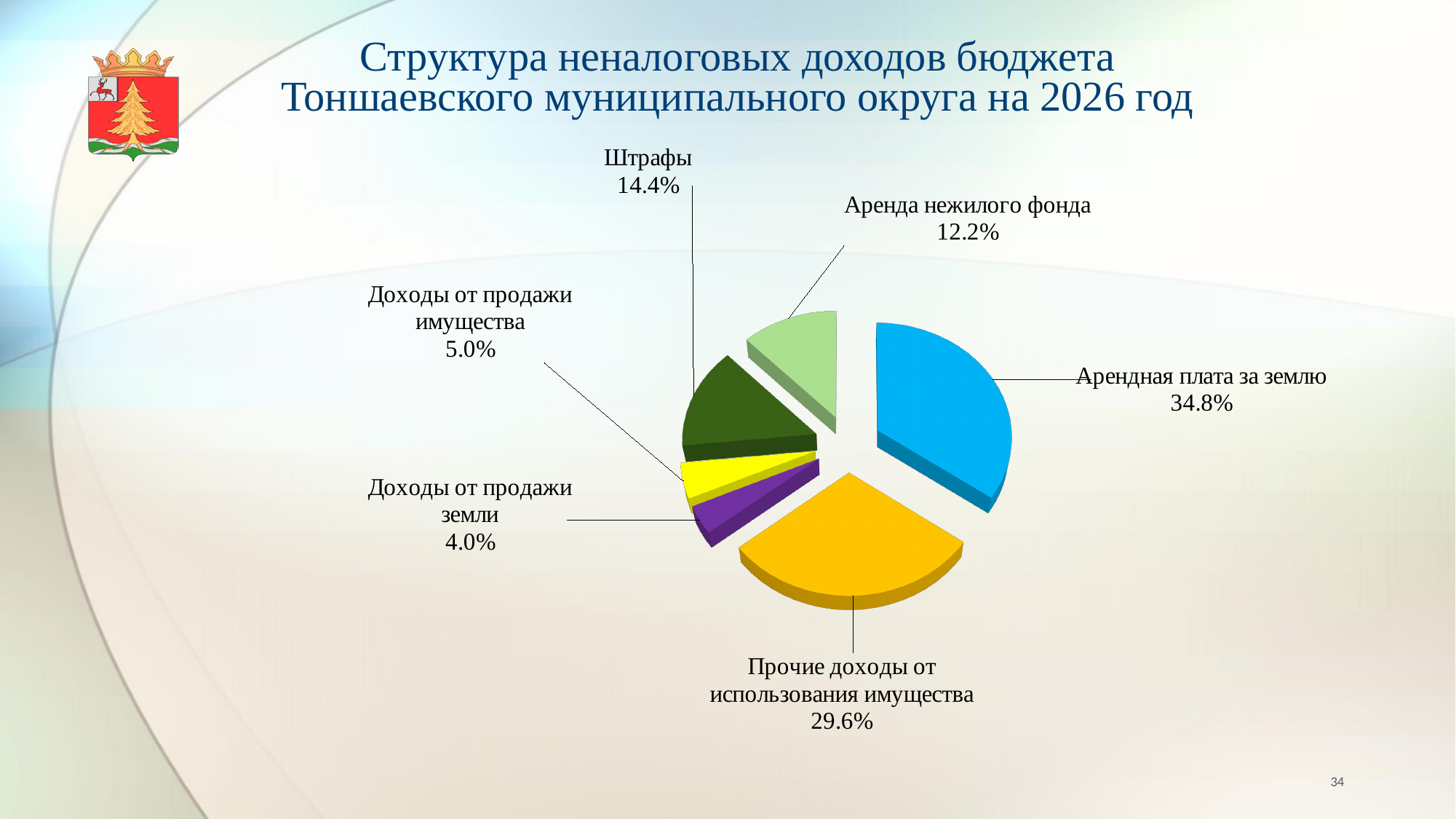
What percentage is labelled for "Штрафы"? 14.4% How many categories are shown in the pie chart? 6 What colour is the slice for "Арендная плата за землю"? Blue What share is shown for "Прочие доходы от использования имущества"? 29.6% What type of chart is shown on the slide? Pie chart Which category has the largest share of the pie? Арендная плата за землю What is the difference in percentage points between "Арендная плата за землю" and "Прочие доходы от использования имущества"? 5.2 What share is shown for "Аренда нежилого фонда"? 12.2% Which is larger: the share for "Штрафы" or the share for "Аренда нежилого фонда"? Штрафы Which category has the smallest share of the pie? Доходы от продажи земли What share of non-tax revenues does "Арендная плата за землю" account for? 34.8% What percentage is shown for "Доходы от продажи земли"? 4.0%